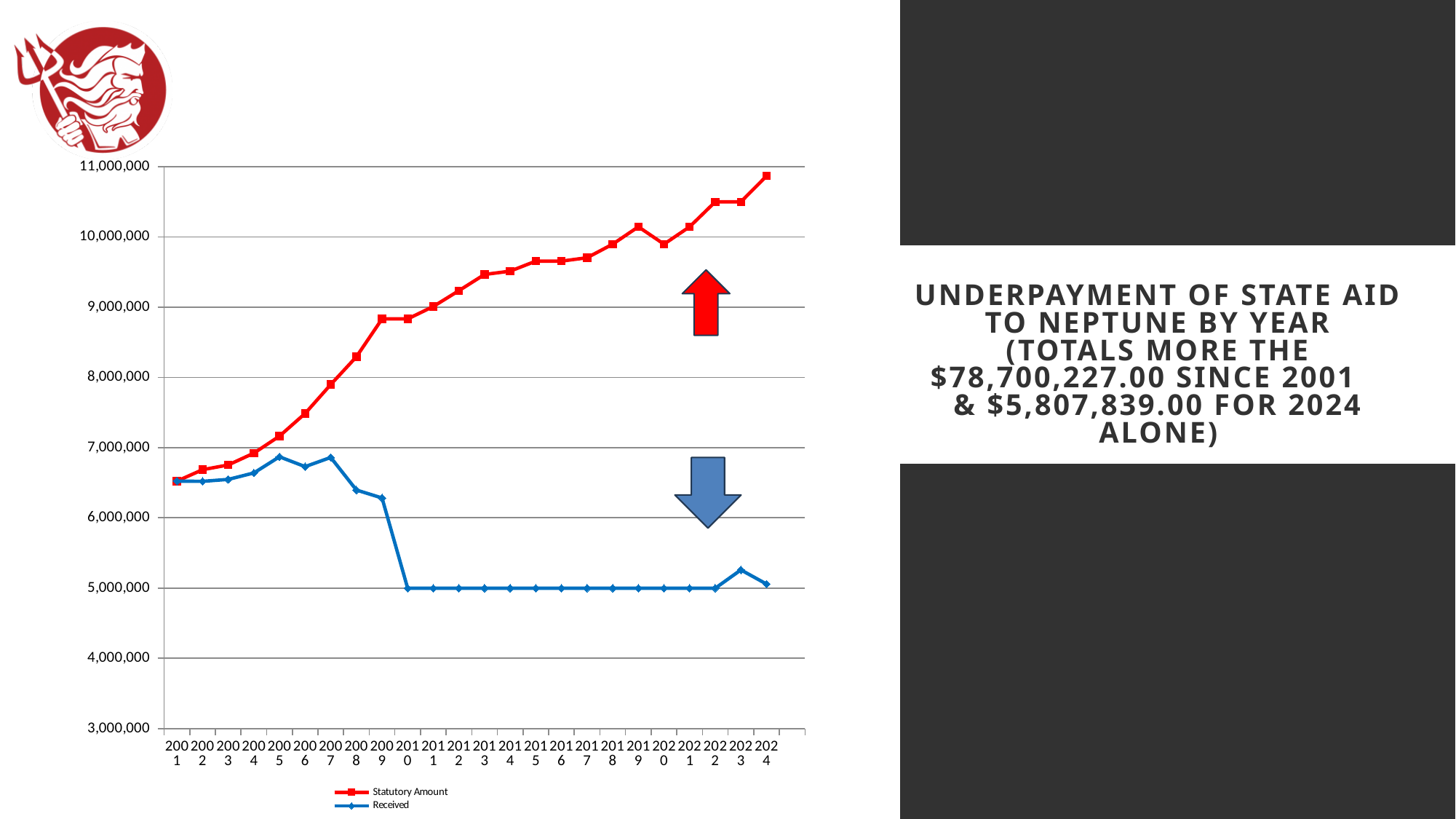
What are the two series named in the chart's legend? Statutory Amount and Received Is the Statutory Amount for 2024 greater or less than 10,000,000? greater Is the Statutory Amount for 2001 greater or less than 7,000,000? less Is the Received amount for 2009 greater or less than 6,000,000? greater In which year is the Statutory Amount highest? 2024 In 2024, which is larger: the Statutory Amount or the Received amount? Statutory Amount How many series does the chart's legend list? 2 How many years are plotted along the x axis of the chart? 24 Does the Statutory Amount series rise or fall from 2001 to 2024? rise In which year is the Statutory Amount lowest? 2001 What kind of chart is shown on the slide? line chart